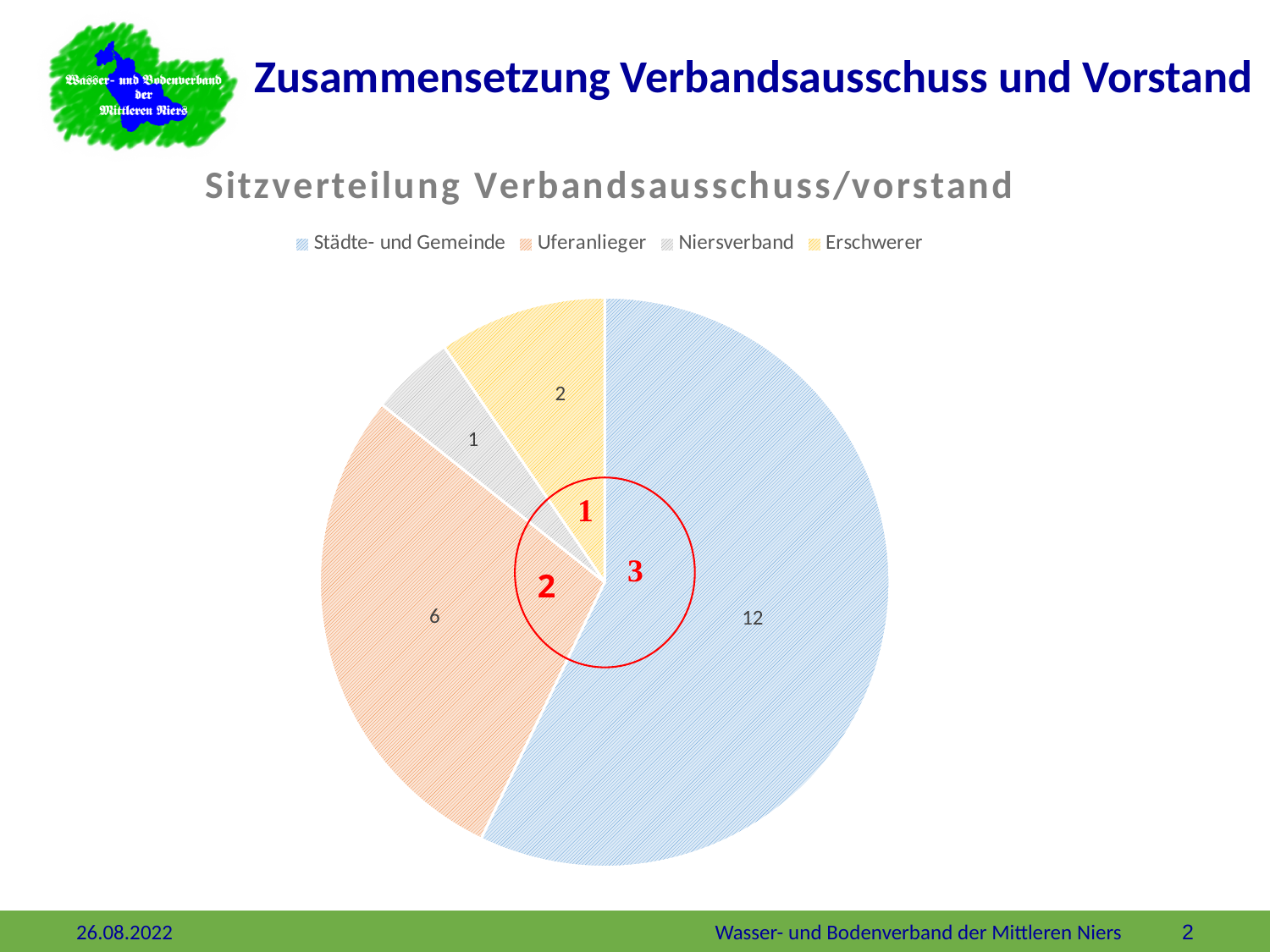
How many slices does the pie chart have? 4 What value is shown for Niersverband? 1 What is the title of the chart? Sitzverteilung Verbandsausschuss/vorstand Which category has the smallest slice of the pie? Niersverband What is the difference between the values for Städte- und Gemeinde and Uferanlieger? 6 What value is shown for Erschwerer? 2 What value is shown for Uferanlieger? 6 Which is larger, the value for Erschwerer or the value for Niersverband? Erschwerer How many categories does the legend of the pie chart list? 4 What kind of chart is shown on the slide? Pie chart What value is shown for Städte- und Gemeinde? 12 Which category has the largest slice of the pie? Städte- und Gemeinde